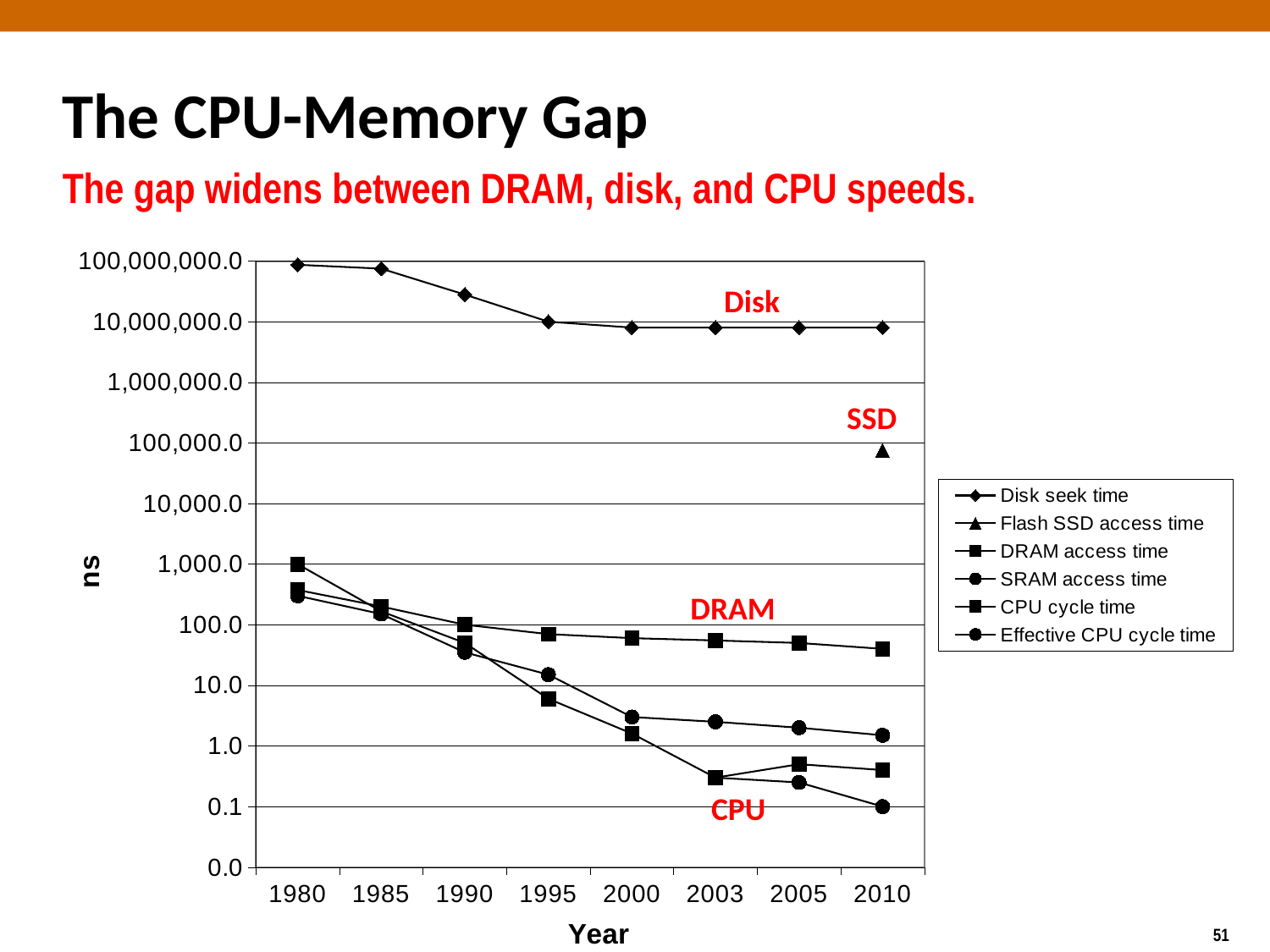
How many years are marked along the x axis? 8 What is the label on the y axis of the chart? ns What kind of chart is shown on the slide? line chart Is the Disk seek time in 1980 greater or less than 10,000,000.0? greater How many series does the legend list? 6 Is the Effective CPU cycle time in 2010 greater or less than 1.0? less Does the Disk seek time rise or fall from 1980 to 2010? fall Is the DRAM access time in 2010 greater or less than 100.0? less In 2010, which is larger: the Disk seek time or the DRAM access time? Disk seek time Does the DRAM access time rise or fall from 1980 to 2010? fall In 2010, which is larger: the DRAM access time or the SRAM access time? DRAM access time